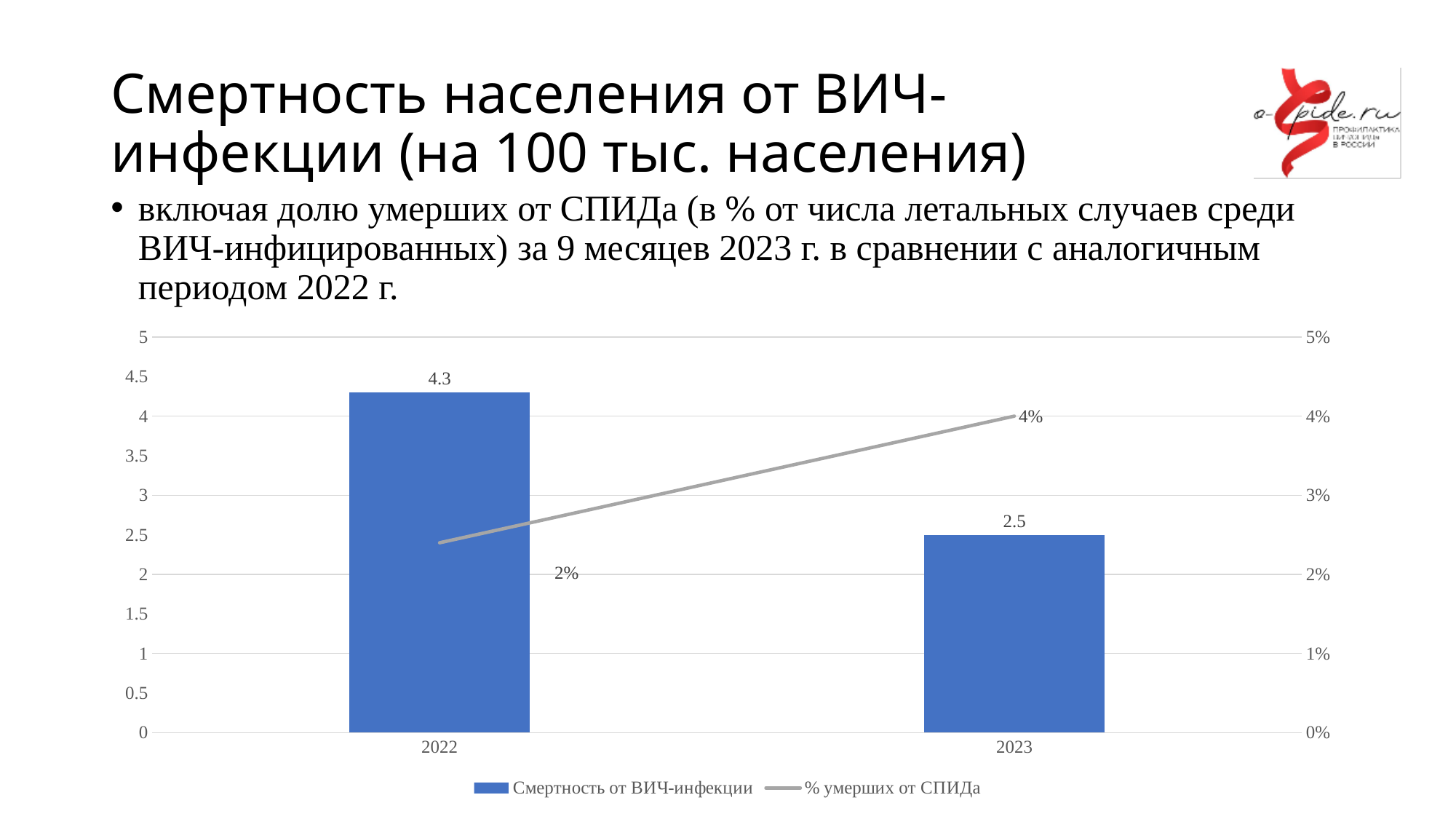
What is the value of % умерших от СПИДа for 2022? 2% Which year has the lower value for % умерших от СПИДа? 2022 What is the value of % умерших от СПИДа for 2023? 4% Which year has the higher value for Смертность от ВИЧ-инфекции? 2022 What is the difference between the Смертность от ВИЧ-инфекции values for 2022 and 2023? 1.8 How many years are shown on the x axis of the chart? 2 Is the value of Смертность от ВИЧ-инфекции for 2023 greater or less than 3? less Is the value of % умерших от СПИДа larger in 2022 or in 2023? 2023 How many series does the chart legend list? 2 What is the value of Смертность от ВИЧ-инфекции for 2023? 2.5 What is the value of Смертность от ВИЧ-инфекции for 2022? 4.3 Does the Смертность от ВИЧ-инфекции series rise or fall from 2022 to 2023? fall